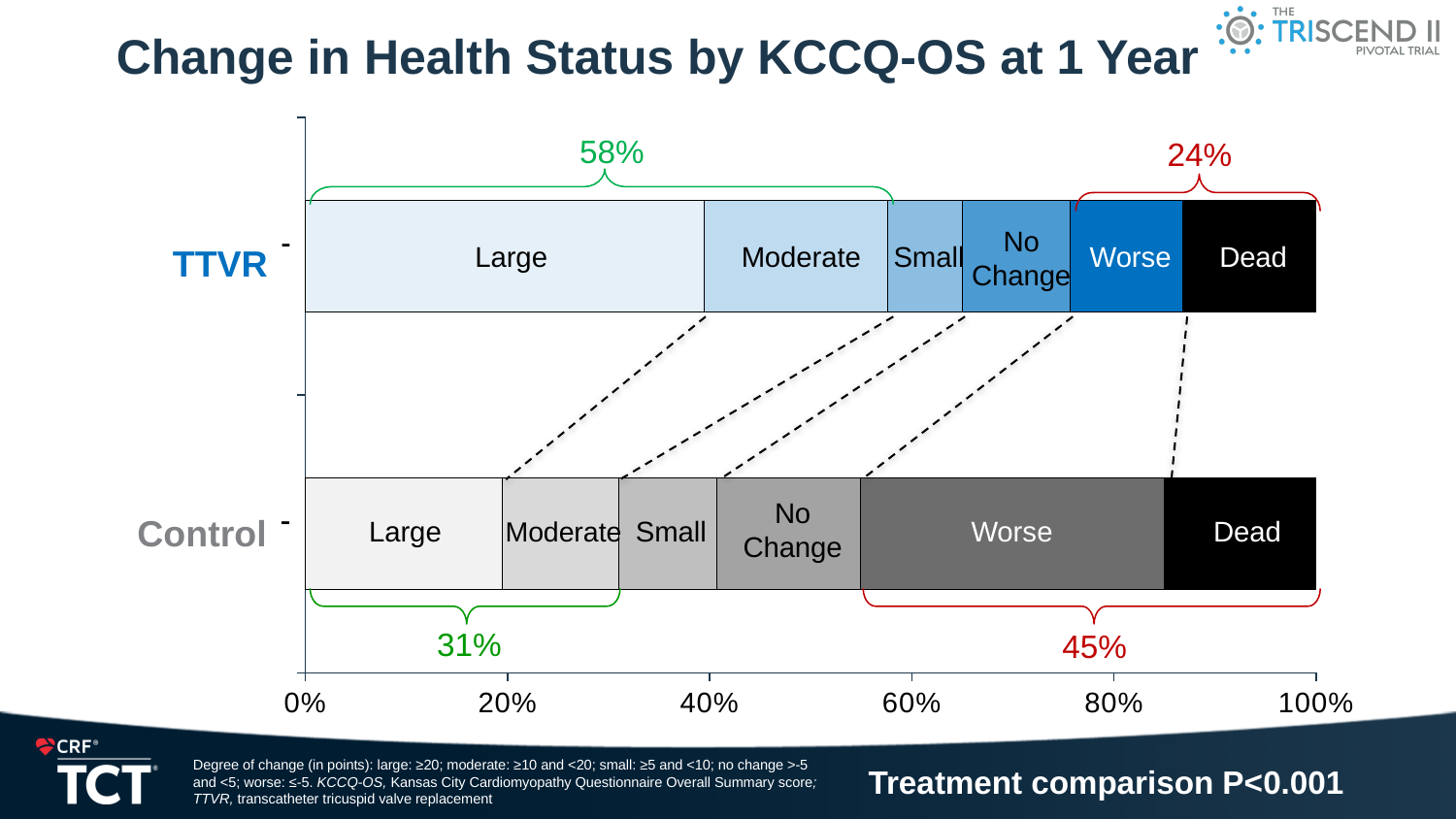
By how many percentage points does the improved share for TTVR (58%) exceed that for Control (31%)? 27 percentage points What kind of chart is shown on the slide? Stacked bar chart Which group has the larger share of patients who were worse or dead, TTVR or Control? Control How many health-status categories make up each bar? 6 Is the share of the Large segment in the TTVR bar greater or less than 20%? greater By how many percentage points is the worse-or-dead share higher for Control (45%) than for TTVR (24%)? 21 percentage points How many treatment groups (bars) are plotted in the chart? 2 Which category is the largest segment of the Control bar? Worse What percentage of TTVR patients were worse or dead at 1 year (the red bracket)? 24% What percentage of Control patients were worse or dead at 1 year? 45%